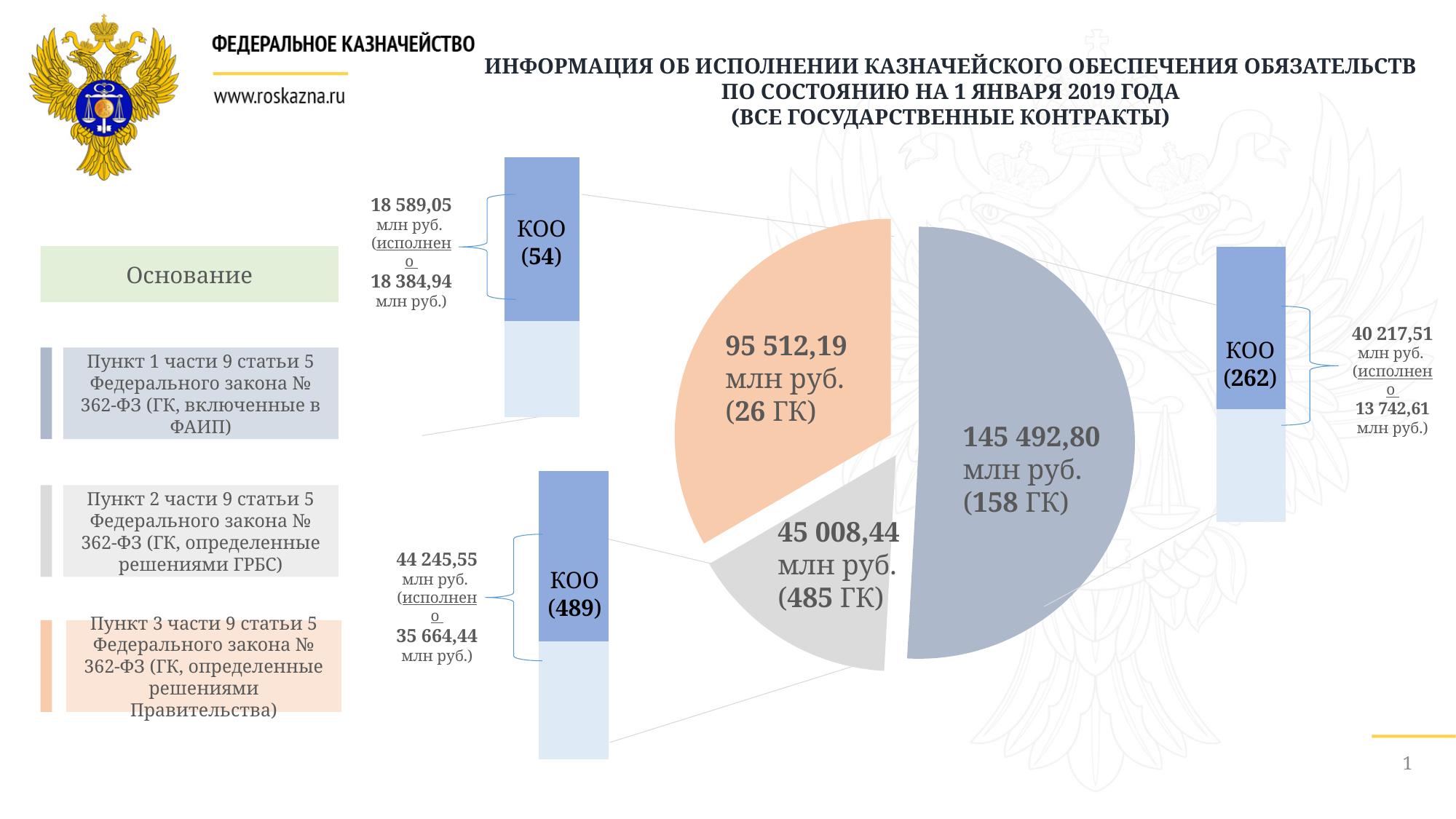
What amount is shown for the bar labelled КОО (489)? 44 245,55 млн руб. Which slice of the pie chart is the smallest? 45 008,44 млн руб. (485 ГК) What is the difference between the 145 492,80 млн руб. slice and the 95 512,19 млн руб. slice? 49 980,61 млн руб. What executed (исполнено) amount is shown for the bar labelled КОО (262)? 13 742,61 млн руб. What kind of chart is shown in the centre of the slide? pie chart What executed (исполнено) amount is shown for the bar labelled КОО (54)? 18 384,94 млн руб. Which is larger: the slice for 26 ГК or the slice for 485 ГК? 26 ГК (95 512,19 млн руб.) How many slices does the pie chart have? 3 How many government contracts (ГК) does the orange slice of the pie chart represent? 26 ГК What is the total of the three pie chart slices in млн руб.? 286 013,43 млн руб. What is the value of the largest slice of the pie chart? 145 492,80 млн руб. Which colour in the legend corresponds to Пункт 3 части 9 статьи 5 Федерального закона № 362-ФЗ? orange